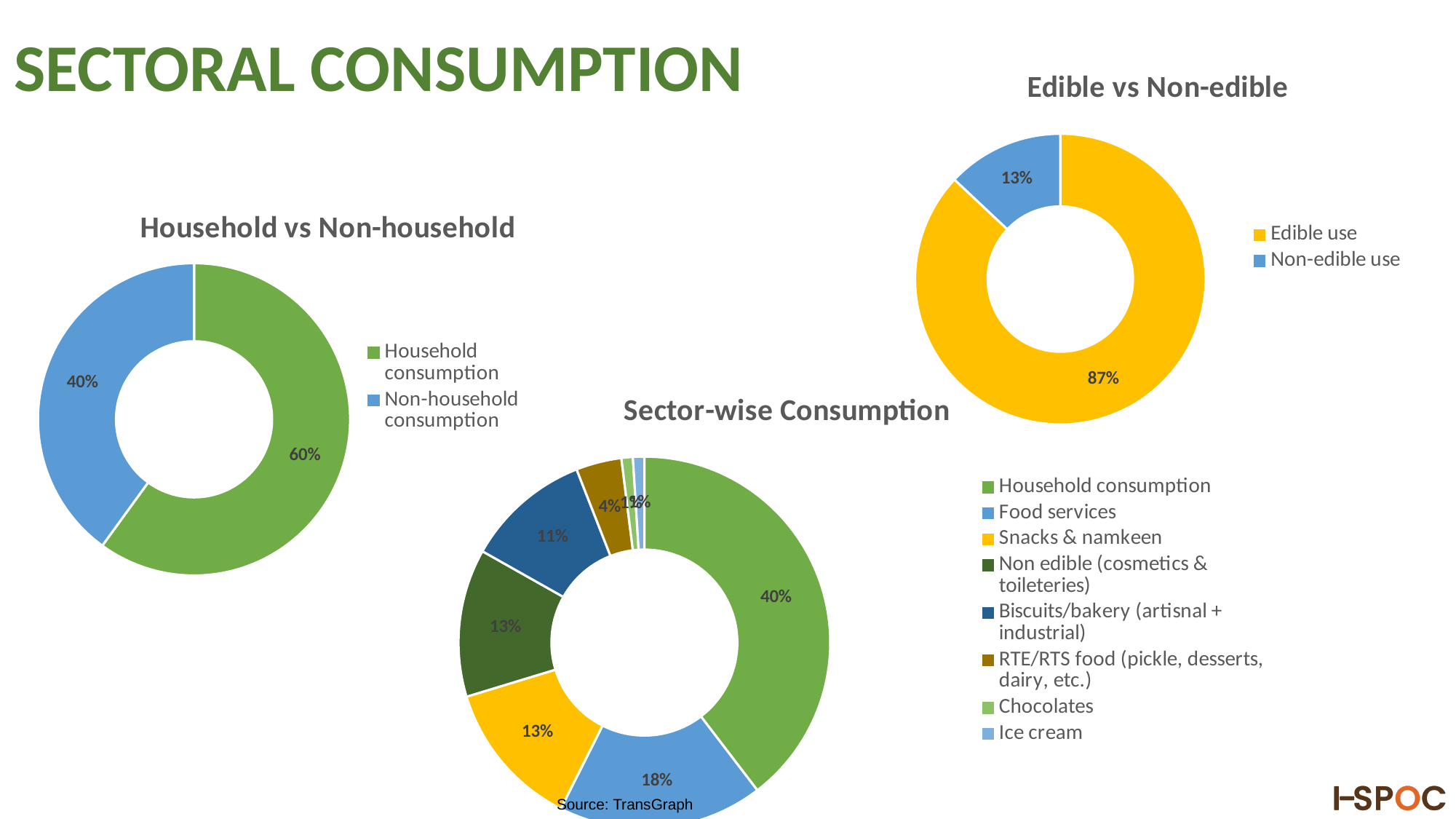
In the Edible vs Non-edible chart, what is the difference between Edible use and Non-edible use? 74% In the Sector-wise Consumption chart, which category has the largest share? Household consumption In the Sector-wise Consumption chart, what is the difference between Household consumption and Food services? 22% What kind of chart is the Edible vs Non-edible chart? Doughnut chart In the Edible vs Non-edible chart, what colour represents Non-edible use? Blue In the Sector-wise Consumption chart, what share is Biscuits/bakery (artisnal + industrial)? 11% In the Edible vs Non-edible chart, what share is Edible use? 87% In the Household vs Non-household chart, what share is Household consumption? 60% In the Sector-wise Consumption chart, what share is Food services? 18% In the Sector-wise Consumption chart, how many categories does the legend list? 8 In the Household vs Non-household chart, what share is Non-household consumption? 40% In the Sector-wise Consumption chart, which is larger: Food services or RTE/RTS food? Food services